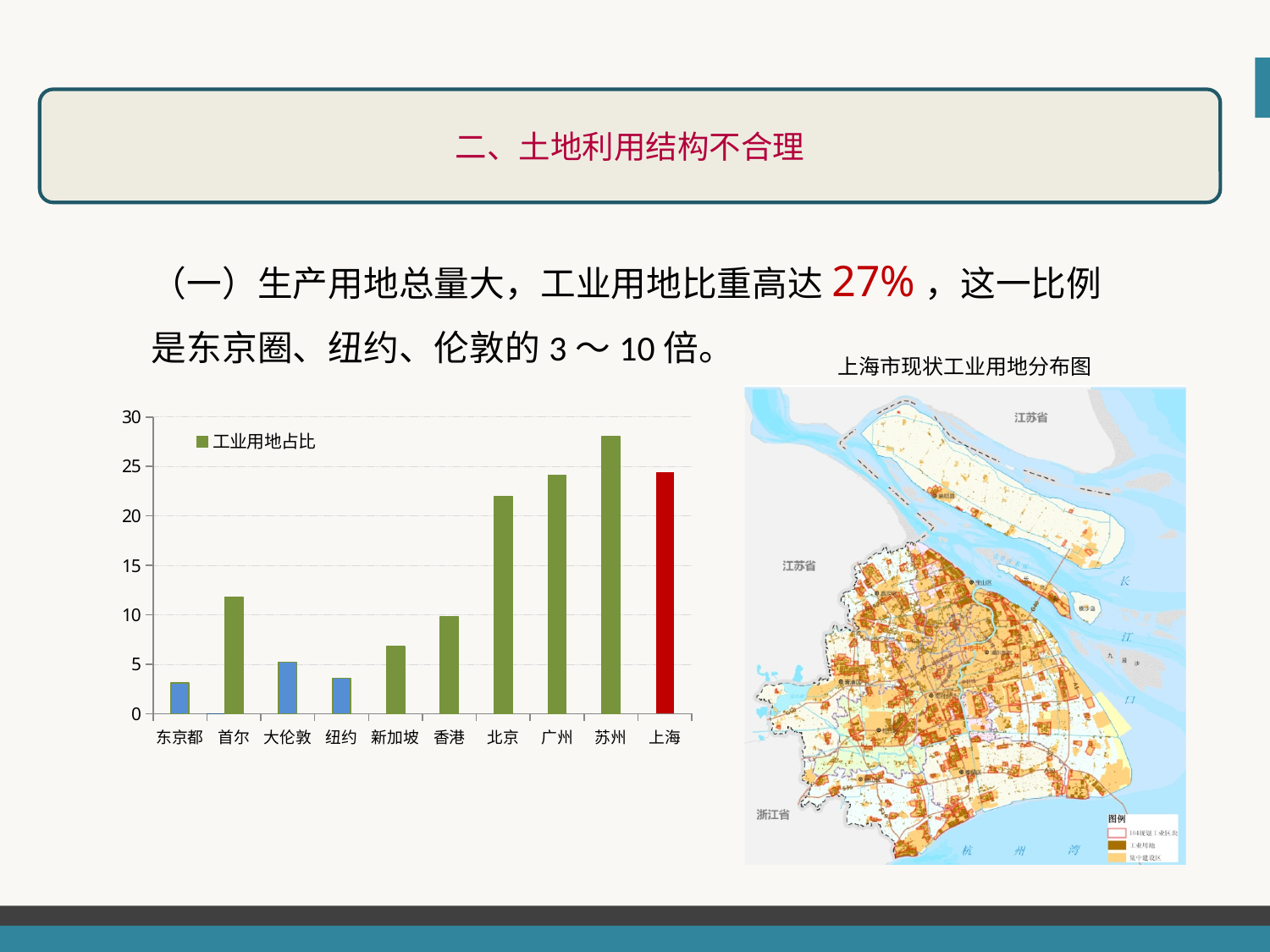
Is the value for 首尔 greater or less than 10? greater What is the legend entry of the bar chart? 工业用地占比 Which bar in the chart is coloured red rather than green? 上海 How many series does the legend of the bar chart list? 1 Which has the larger value, 首尔 or 香港? 首尔 Is the value for 北京 greater or less than 20? greater How many cities are shown on the x axis of the bar chart? 10 Is the value for 苏州 greater or less than 25? greater Which has the larger value, 苏州 or 上海? 苏州 Which city has the highest bar in the chart? 苏州 What kind of chart is shown on the slide? bar chart